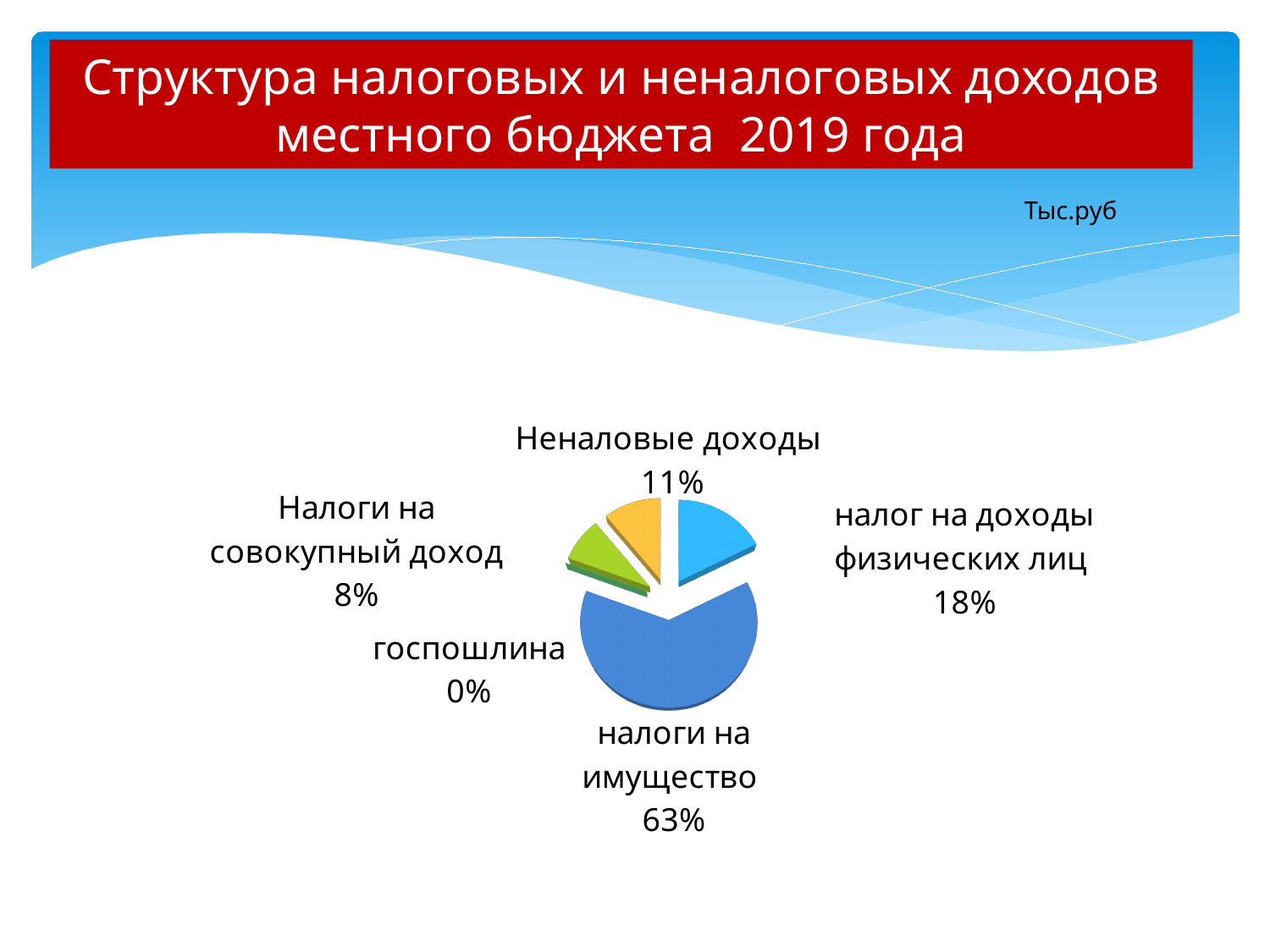
Which category has the largest share of the pie? налоги на имущество What is the difference in percentage points between "налоги на имущество" and "налог на доходы физических лиц"? 45 How many categories are shown in the pie chart? 5 Which is larger: the share for "Неналовые доходы" or the share for "Налоги на совокупный доход"? Неналовые доходы What share of the pie does "госпошлина" have? 0% Which category has the smallest share of the pie? госпошлина What unit is indicated on the slide above the chart? Тыс.руб What share of the pie does "Налоги на совокупный доход" have? 8% What share of the pie does "налоги на имущество" have? 63% What kind of chart is shown on the slide? pie chart